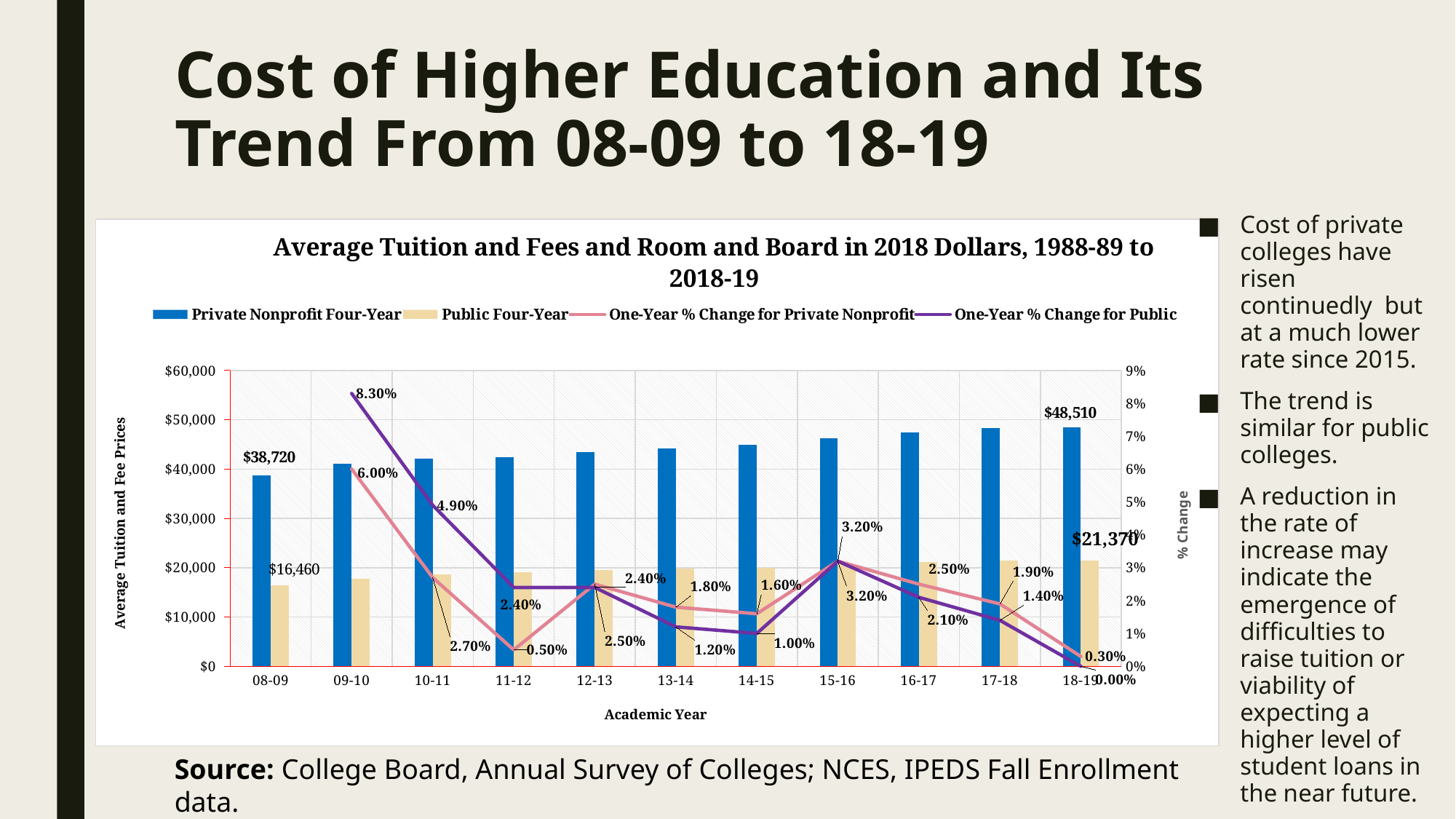
By how much did the Private Nonprofit Four-Year value increase from 08-09 to 18-19? $9,790 What is the value for Private Nonprofit Four-Year in 08-09? $38,720 In which academic year is the One-Year % Change for Public highest? 09-10 How many series does the legend list? 4 What is the One-Year % Change for Public in 09-10? 8.30% What is the value for Private Nonprofit Four-Year in 18-19? $48,510 By how much did the Public Four-Year value increase from 08-09 to 18-19? $4,910 In which academic year is the One-Year % Change for Public lowest? 18-19 What is the value for Public Four-Year in 18-19? $21,370 How many academic years are shown on the x axis? 11 What is the value for Public Four-Year in 08-09? $16,460 Is the Private Nonprofit Four-Year value for 13-14 greater or less than $40,000? greater